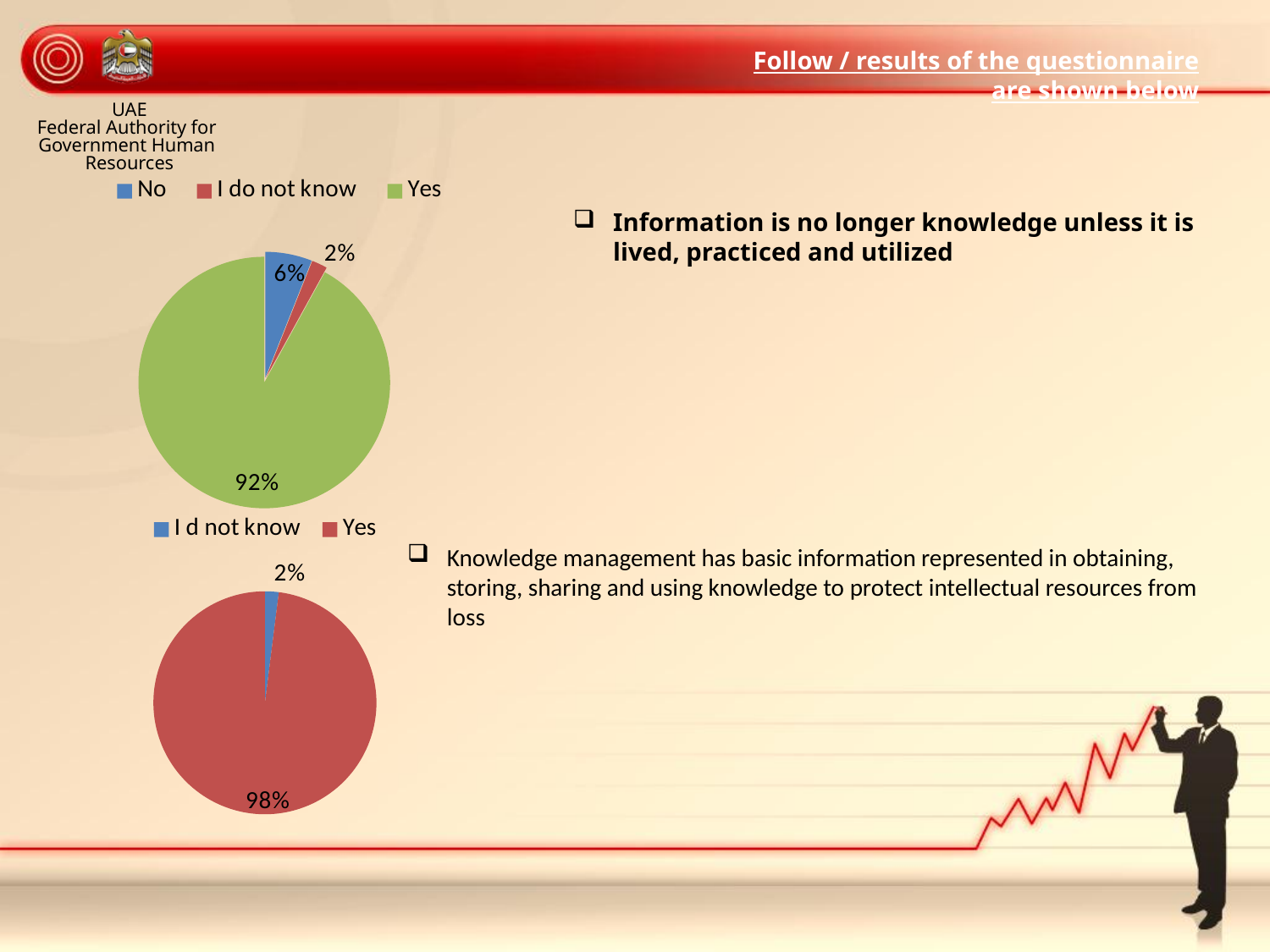
In the top pie chart, what percentage is shown for Yes? 92% In the bottom pie chart, which category has the larger share, Yes or I d not know? Yes In the top pie chart, what colour represents the Yes category? Green What type of chart is the bottom chart on the slide? Pie chart In the top pie chart, which category has the smallest share? I do not know In the top pie chart, how many categories does the legend list? 3 In the bottom pie chart, what percentage is shown for I d not know? 2% In the top pie chart, what percentage is shown for No? 6% In the top pie chart, what percentage is shown for I do not know? 2% In the top pie chart, what is the difference in percentage points between Yes and No? 86 In the bottom pie chart, what percentage is shown for Yes? 98% In the top pie chart, which category has the largest share? Yes